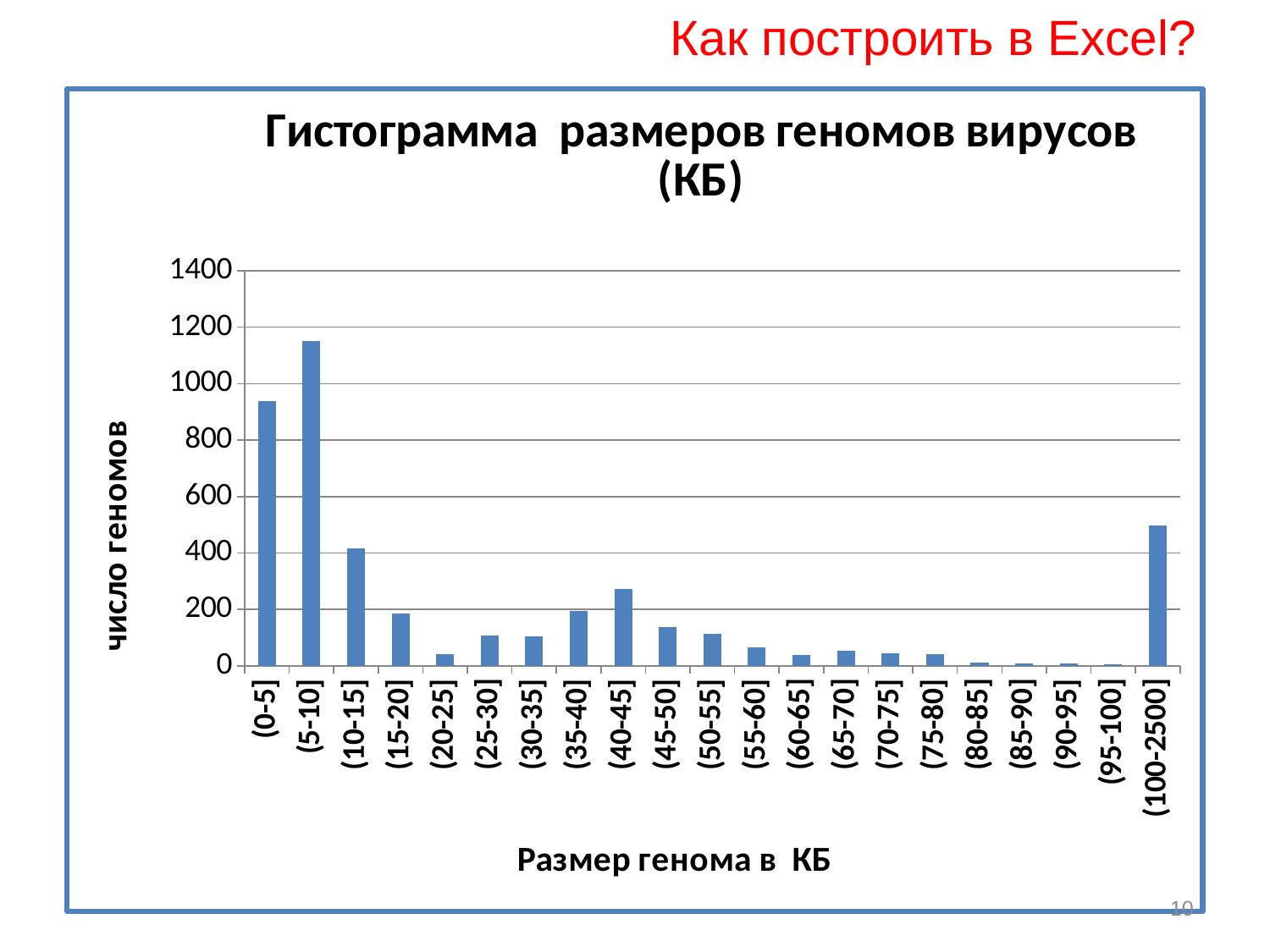
What is the label of the vertical axis? число геномов Is the value for the (40-45] bin greater or less than 200? greater Is the value for the (5-10] bin greater or less than 1000? greater Which genome size bin has the highest number of genomes? (5-10] Which bin has more genomes, (40-45] or (35-40]? (40-45] What kind of chart is shown on the slide? Bar chart Is the value for the (0-5] bin greater or less than 1000? less Which bin has more genomes, (0-5] or (100-2500]? (0-5] How many genome size bins are shown on the x axis? 21 What is the title of the chart? Гистограмма размеров геномов вирусов (КБ)